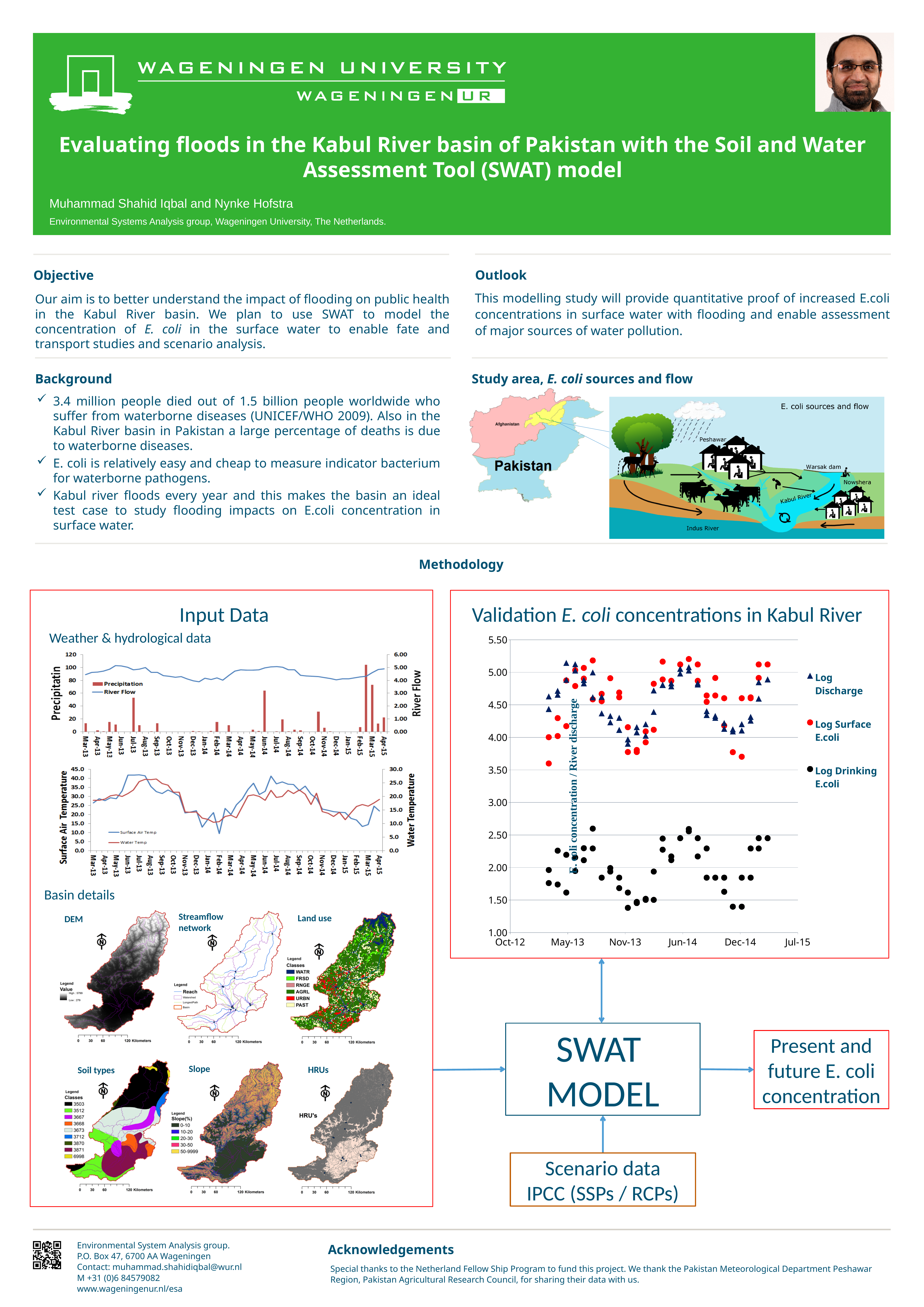
How many series does the legend of the Surface Air Temperature / Water Temperature chart list? 2 In the 'Weather & hydrological data' chart, which month has the highest precipitation bar? Feb-15 In the Surface Air Temperature / Water Temperature chart, is the Surface Air Temp value for Jul-13 greater or less than 35.0? greater In the 'Weather & hydrological data' chart, how many series does the legend list? 2 In the 'Validation E. coli concentrations in Kabul River' chart, which series is plotted with black circles? Log Drinking E.coli In the 'Weather & hydrological data' chart, what is the label of the right-hand vertical axis? River Flow How many series does the legend of the 'Validation E. coli concentrations in Kabul River' chart list? 3 What kind of chart is the Surface Air Temperature / Water Temperature chart in the Input Data panel? line chart In the 'Weather & hydrological data' chart, is the precipitation bar for Jun-14 greater or less than 40? greater In the 'Validation E. coli concentrations in Kabul River' chart, are the Log Surface E.coli values greater or less than 3.50? greater What kind of chart is the 'Validation E. coli concentrations in Kabul River' chart? scatter chart